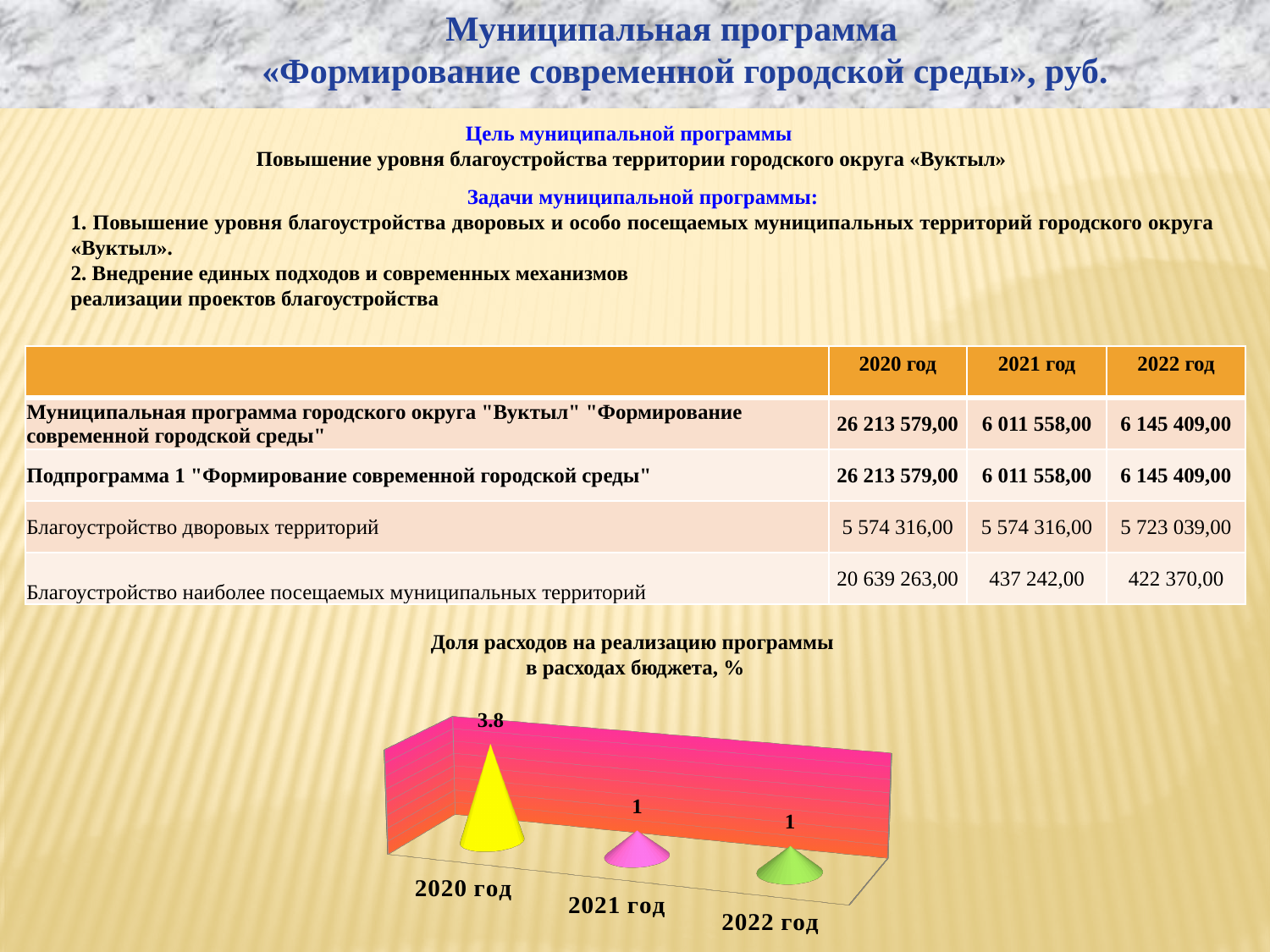
What is the value for 2022 год in the chart? 1 What is the difference between the values for 2020 год and 2022 год? 2.8 How many categories are shown in the chart? 3 Which year has the highest value in the chart? 2020 год What is the title of the chart? Доля расходов на реализацию программы в расходах бюджета, % What colour is the cone for 2020 год? yellow What is the difference between the values for 2020 год and 2021 год? 2.8 What is the value for 2021 год in the chart? 1 What is the value for 2020 год in the chart? 3.8 Which is larger, the value for 2020 год or the value for 2022 год? 2020 год Do the values rise or fall from 2020 год to 2022 год? fall